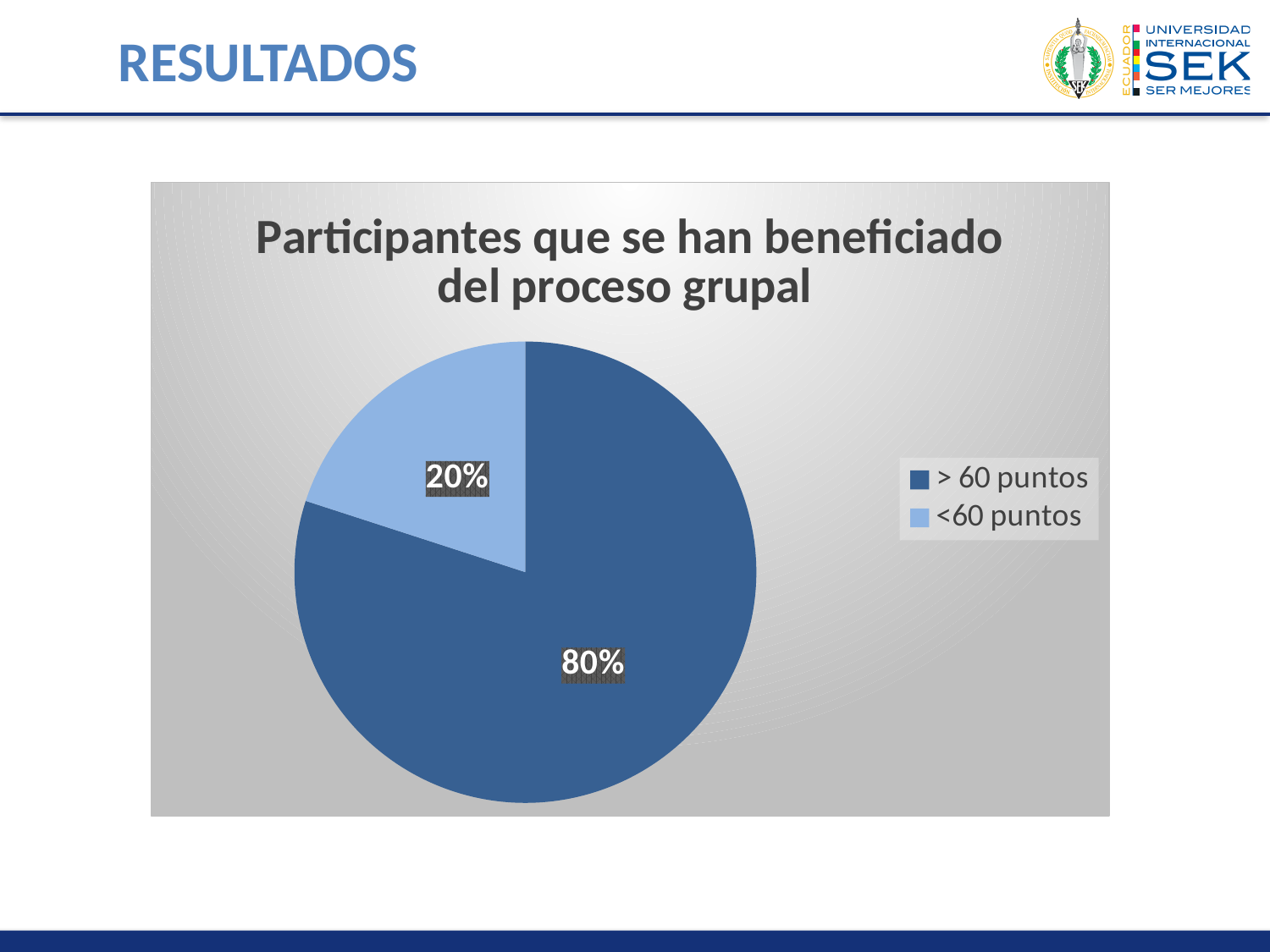
How many categories does the pie chart show? 2 What share of the pie does the "<60 puntos" slice represent? 20% What is the title of the chart? Participantes que se han beneficiado del proceso grupal Which is larger, the "> 60 puntos" slice or the "<60 puntos" slice? > 60 puntos What kind of chart is shown on the slide? Pie chart What colour is the "<60 puntos" slice? Light blue What share of the pie does the "> 60 puntos" slice represent? 80% How many entries does the legend list? 2 Which category has the largest slice of the pie? > 60 puntos Which category has the smallest slice of the pie? <60 puntos What is the difference in percentage points between the "> 60 puntos" and "<60 puntos" slices? 60